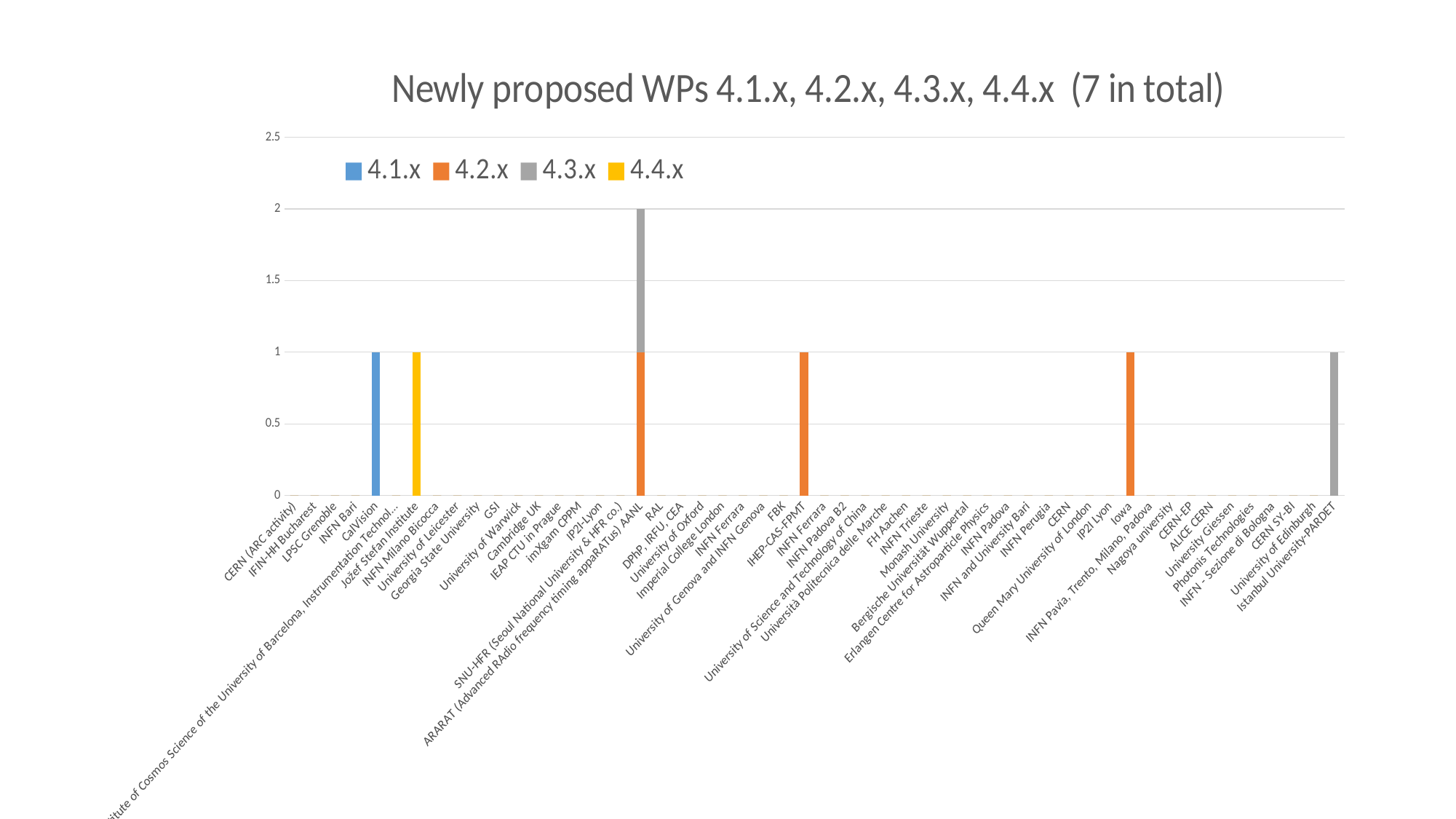
What is the value of the 4.1.x series for CalVision? 1 What is the title of the chart? Newly proposed WPs 4.1.x, 4.2.x, 4.3.x, 4.4.x (7 in total) What is the value of the 4.2.x series for IHEP-CAS-FPMT? 1 Which is larger: the 4.3.x value for ARARAT (Advanced RAdio frequency timing appaRATus) AANL or the 4.1.x value for CalVision? Neither; both are 1 Which category has the highest bar in the chart? ARARAT (Advanced RAdio frequency timing appaRATus) AANL What kind of chart is shown on the slide? bar chart What is the value of the 4.3.x series for ARARAT (Advanced RAdio frequency timing appaRATus) AANL? 1 Which series is shown in orange in the legend? 4.2.x What is the value of the 4.3.x series for Istanbul University-PARDET? 1 What is the value of the 4.4.x series for Jožef Stefan Institute? 1 What is the difference between the 4.3.x value for ARARAT (Advanced RAdio frequency timing appaRATus) AANL and the 4.2.x value for Iowa? 0 How many series does the legend list? 4